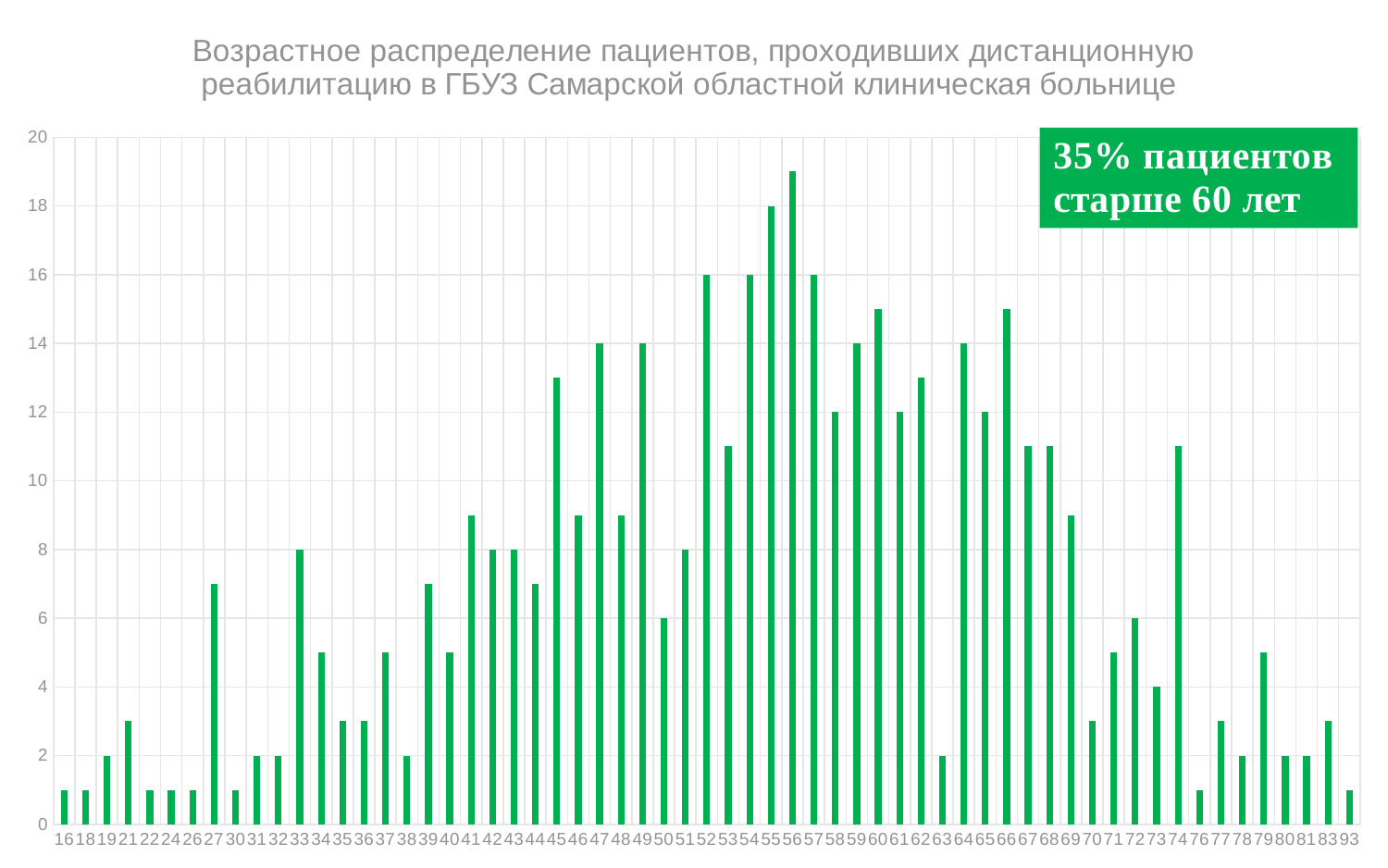
Is the value for age 74 greater or less than 10? greater What percentage of patients are older than 60 years according to the text box on the slide? 35% How many patients are shown for age 55? 18 What is the difference between the values for age 55 and age 52? 2 How many patients are shown for age 33? 8 How many patients are shown for age 47? 14 Which has a larger value, age 47 or age 41? 47 What type of chart is shown on the slide? bar chart How many patients are shown for age 52? 16 Which age has the highest number of patients? 56 Is the value for age 45 greater or less than 12? greater What is the maximum value shown on the vertical axis? 20